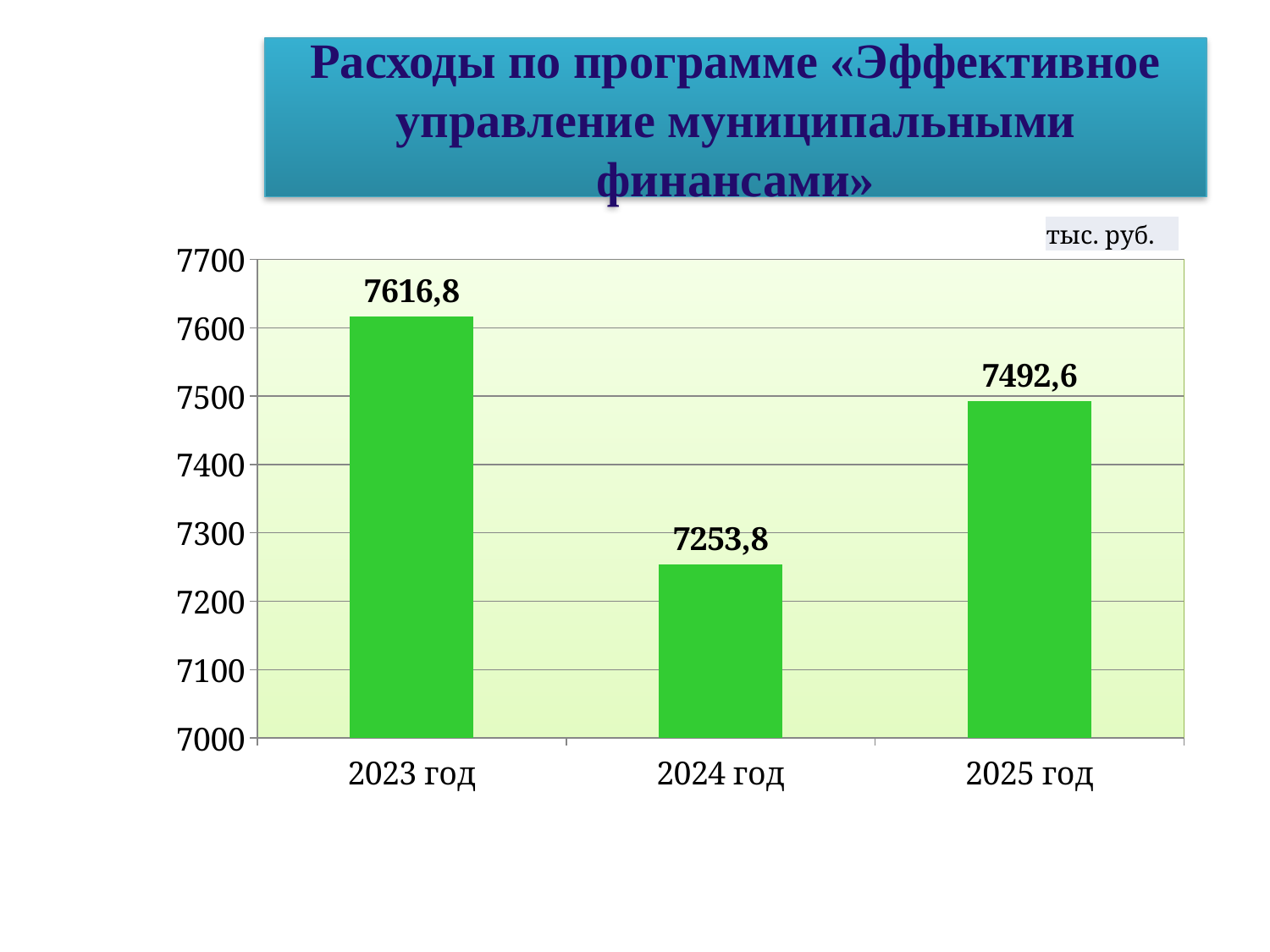
Which year has the highest value? 2023 год Which is larger, the value for 2025 год or the value for 2024 год? 2025 год In what units are the values on the chart given? тыс. руб. What is the difference between the values for 2023 год and 2024 год? 363,0 What is the value for 2025 год? 7492,6 Is the value for 2024 год greater or less than 7300? less What is the value for 2023 год? 7616,8 What kind of chart is shown on the slide? bar chart How many years are shown on the chart? 3 Which year has the lowest value? 2024 год What is the difference between the values for 2025 год and 2024 год? 238,8 What is the value for 2024 год? 7253,8